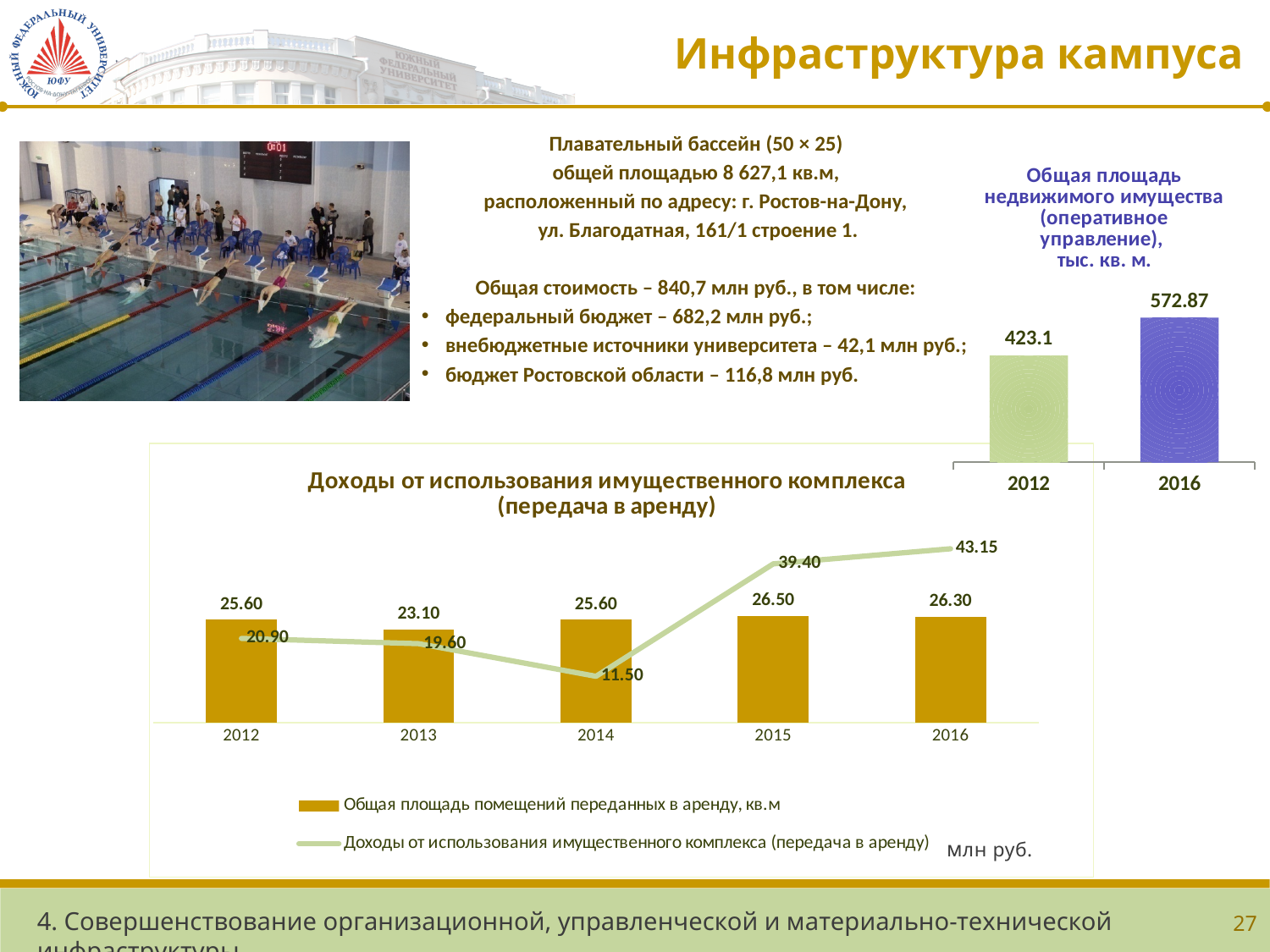
In the chart 'Доходы от использования имущественного комплекса (передача в аренду)', what is the value of the bar series 'Общая площадь помещений переданных в аренду, кв.м' for 2013? 23.10 In the chart 'Доходы от использования имущественного комплекса (передача в аренду)', what is the value of the line series 'Доходы от использования имущественного комплекса (передача в аренду)' for 2015? 39.40 In the chart 'Доходы от использования имущественного комплекса (передача в аренду)', which is larger for 2015: the bar value or the line value? the line value (39.40) In the chart 'Общая площадь недвижимого имущества (оперативное управление), тыс. кв. м.', what is the difference between the 2016 and 2012 values? 149.77 In the chart 'Доходы от использования имущественного комплекса (передача в аренду)', in which year is the line series 'Доходы от использования имущественного комплекса' highest? 2016 In the chart 'Доходы от использования имущественного комплекса (передача в аренду)', what is the difference between the line values for 2016 and 2014? 31.65 In the chart 'Общая площадь недвижимого имущества (оперативное управление), тыс. кв. м.', what is the value for 2012? 423.1 In the chart 'Общая площадь недвижимого имущества (оперативное управление), тыс. кв. м.', how many categories are shown? 2 In the chart 'Доходы от использования имущественного комплекса (передача в аренду)', how many series does the legend list? 2 In the chart 'Доходы от использования имущественного комплекса (передача в аренду)', how many years are shown on the x axis? 5 In the chart 'Общая площадь недвижимого имущества (оперативное управление), тыс. кв. м.', what is the value for 2016? 572.87 In the chart 'Доходы от использования имущественного комплекса (передача в аренду)', in which year is the line series 'Доходы от использования имущественного комплекса' lowest? 2014